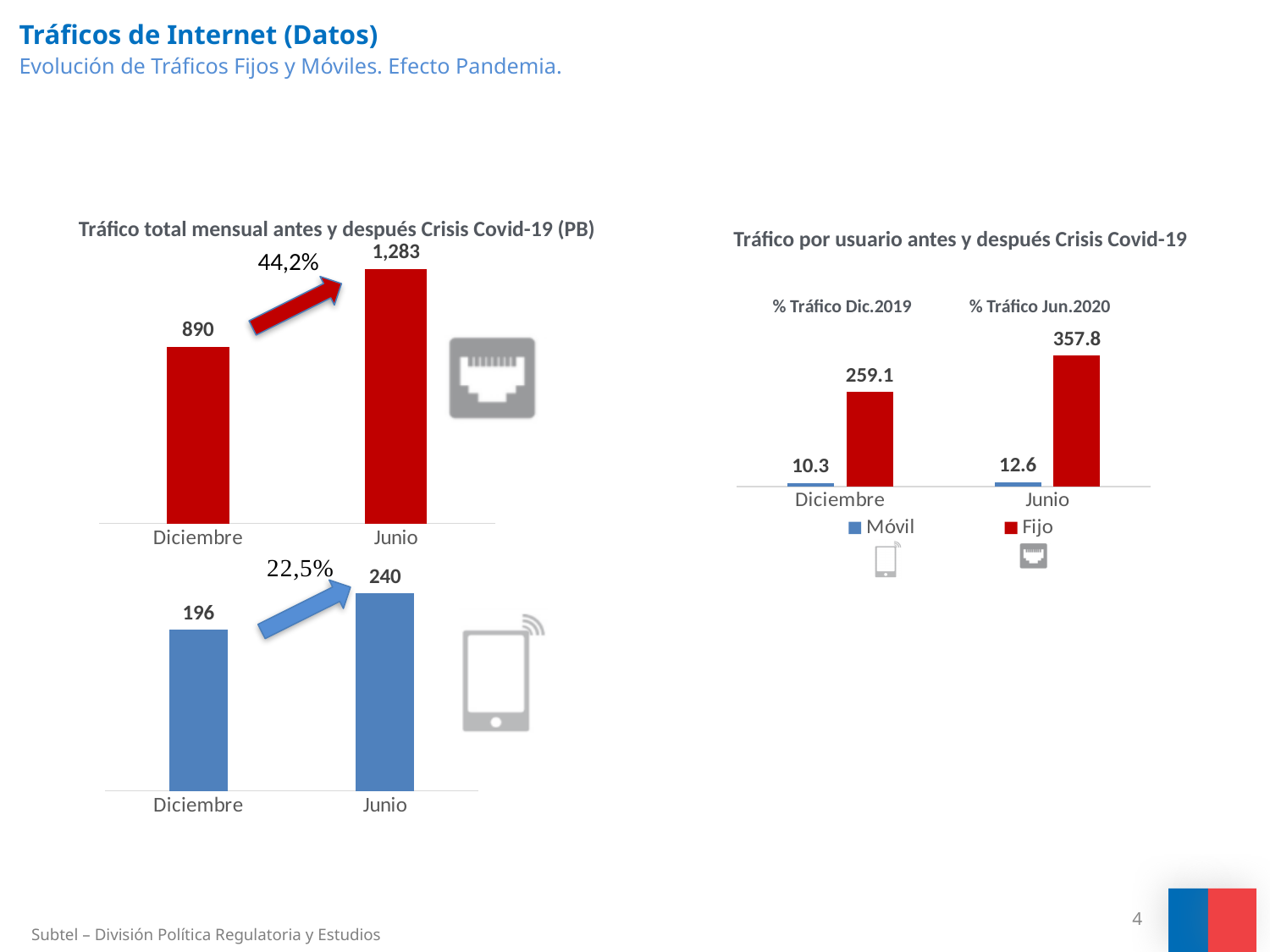
What kind of chart is the top-left chart 'Tráfico total mensual antes y después Crisis Covid-19 (PB)'? bar chart In the bottom-left blue bar chart, do the values rise or fall from Diciembre to Junio? rise In the chart 'Tráfico por usuario antes y después Crisis Covid-19', what is the difference between the Fijo values for Junio and Diciembre? 98.7 In the top-left red bar chart, what is the difference between the Junio and Diciembre values? 393 In the chart 'Tráfico total mensual antes y después Crisis Covid-19 (PB)' (top left, red bars), what is the value for Junio? 1,283 In the chart 'Tráfico total mensual antes y después Crisis Covid-19 (PB)' (top left, red bars), what is the value for Diciembre? 890 In the chart 'Tráfico por usuario antes y después Crisis Covid-19', how many series does the legend list? 2 In the chart 'Tráfico por usuario antes y después Crisis Covid-19', which is larger for Junio, Móvil or Fijo? Fijo In the bottom-left blue bar chart, what is the value for Diciembre? 196 In the bottom-left blue bar chart, what is the value for Junio? 240 In the chart 'Tráfico por usuario antes y después Crisis Covid-19', what is the Móvil value for Diciembre? 10.3 In the chart 'Tráfico por usuario antes y después Crisis Covid-19', what is the Fijo value for Junio? 357.8